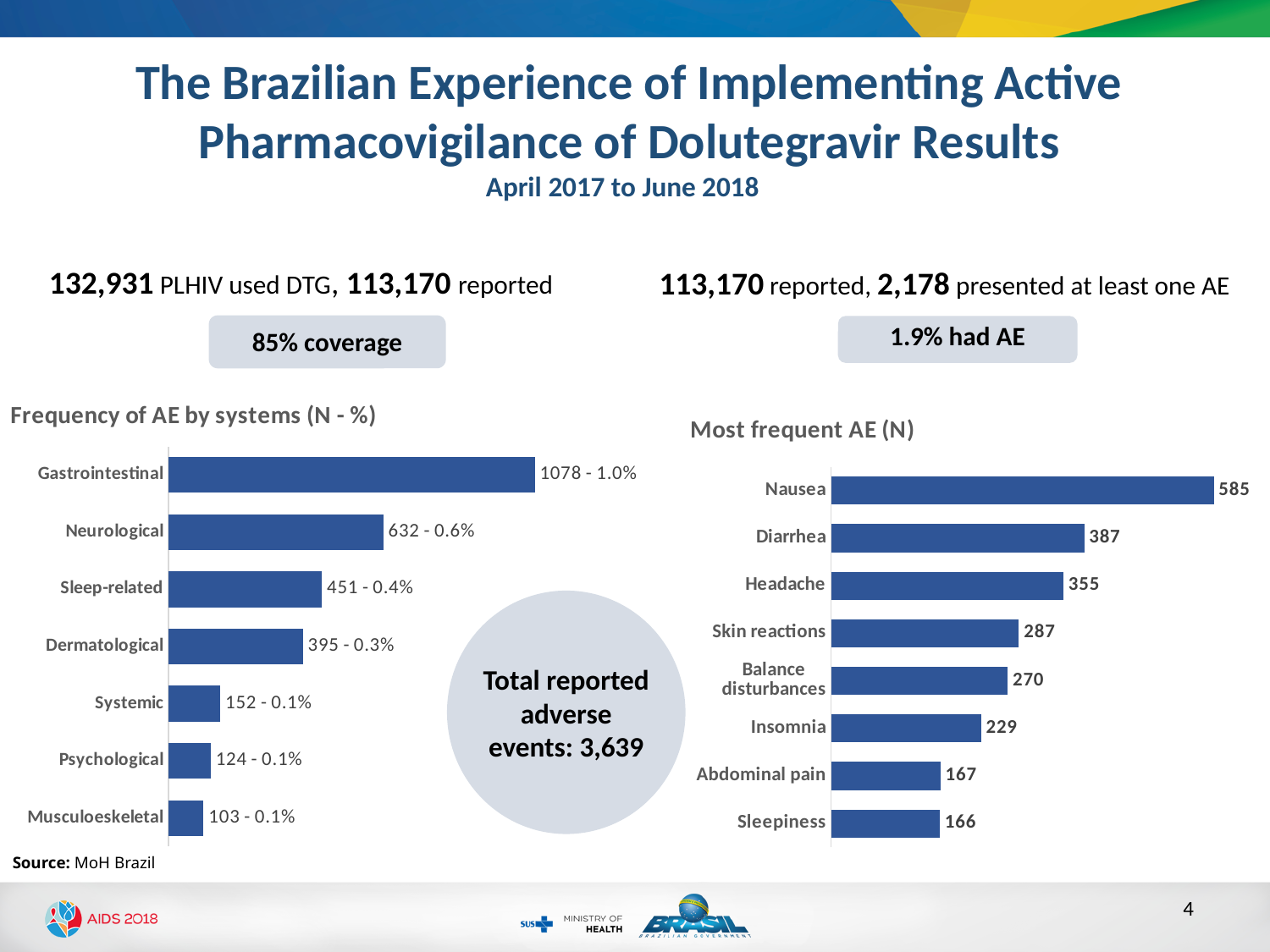
In the 'Frequency of AE by systems (N - %)' chart, which system has the lowest value? Musculoeskeletal What total number of reported adverse events is shown in the circle on the slide? 3,639 In the 'Frequency of AE by systems (N - %)' chart, what is the data label for Gastrointestinal? 1078 - 1.0% In the 'Most frequent AE (N)' chart, what is the difference between Diarrhea and Headache? 32 In the 'Most frequent AE (N)' chart, what is the value for Nausea? 585 In the 'Most frequent AE (N)' chart, what is the value for Balance disturbances? 270 What type of chart is the 'Most frequent AE (N)' chart? Bar chart In the 'Most frequent AE (N)' chart, how many adverse events are listed? 8 In the 'Frequency of AE by systems (N - %)' chart, how many systems are listed? 7 In the 'Most frequent AE (N)' chart, which adverse event has the highest value? Nausea In the 'Frequency of AE by systems (N - %)' chart, which is larger, Dermatological or Systemic? Dermatological In the 'Frequency of AE by systems (N - %)' chart, what is the difference in N between Neurological and Sleep-related? 181